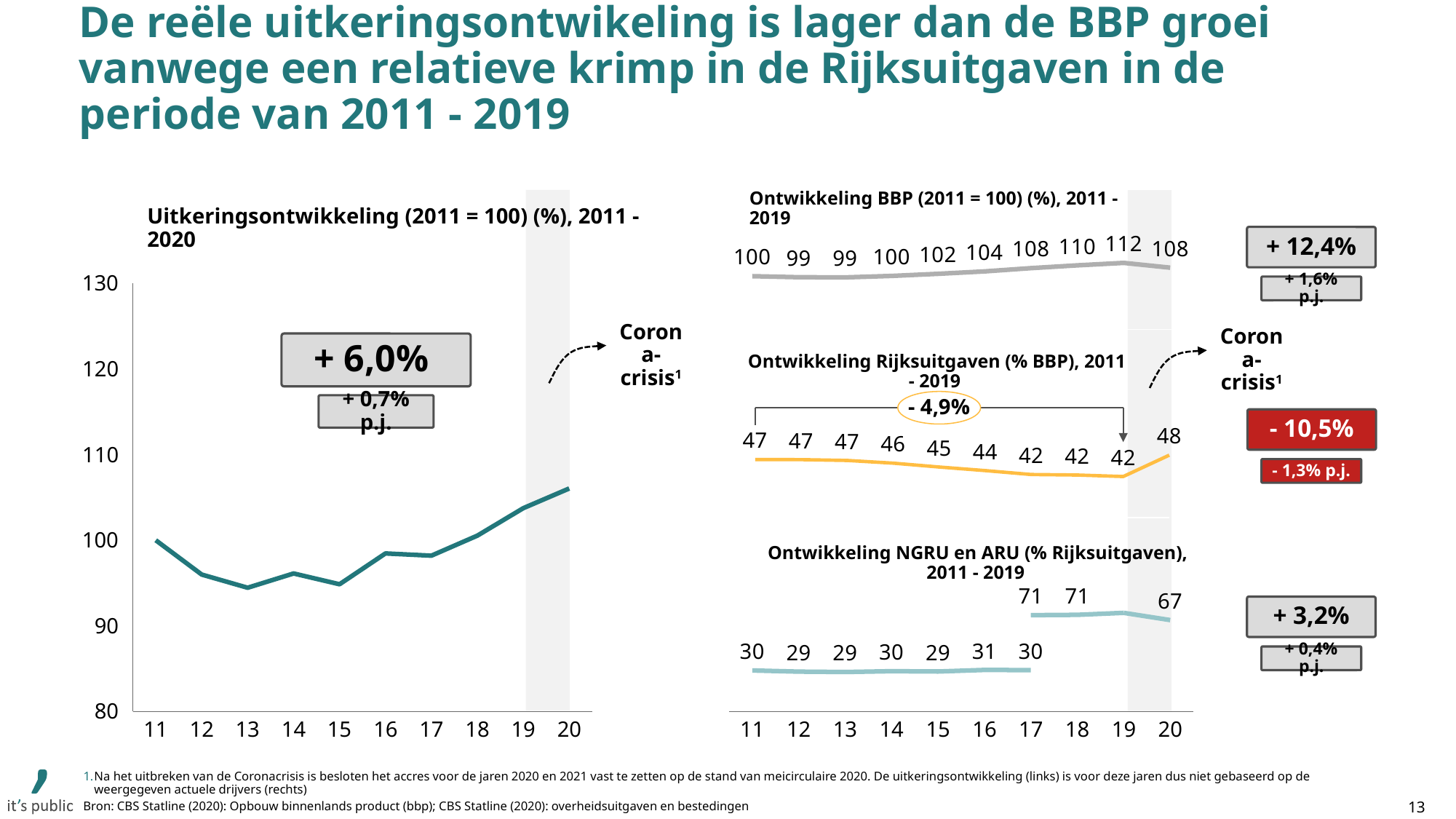
In the 'Ontwikkeling NGRU en ARU (% Rijksuitgaven), 2011 - 2019' chart, which is larger, the value for 19 or the value for 20? 19 In the 'Uitkeringsontwikkeling' chart on the left, is the value for 13 greater or less than 100? less In the 'Uitkeringsontwikkeling' chart on the left, is the value for 20 greater or less than 100? greater What percentage is shown in the large grey box on the 'Uitkeringsontwikkeling' chart on the left? + 6,0% In the 'Ontwikkeling BBP (2011 = 100) (%), 2011 - 2019' chart, what is the difference between the values for 19 and 11? 12 In the 'Ontwikkeling Rijksuitgaven (% BBP), 2011 - 2019' chart, what is the value for 15? 45 In the 'Ontwikkeling BBP (2011 = 100) (%), 2011 - 2019' chart, which year has the highest value? 19 What kind of chart is the 'Uitkeringsontwikkeling (2011 = 100) (%), 2011 - 2020' chart on the left? line chart In the 'Uitkeringsontwikkeling' chart on the left, does the line rise or fall from 15 to 20? rise In the 'Ontwikkeling Rijksuitgaven (% BBP), 2011 - 2019' chart, which year has the highest value? 20 In the 'Ontwikkeling BBP (2011 = 100) (%), 2011 - 2019' chart, what is the value for 19? 112 In the 'Uitkeringsontwikkeling' chart on the left, how many years are shown on the x axis? 10